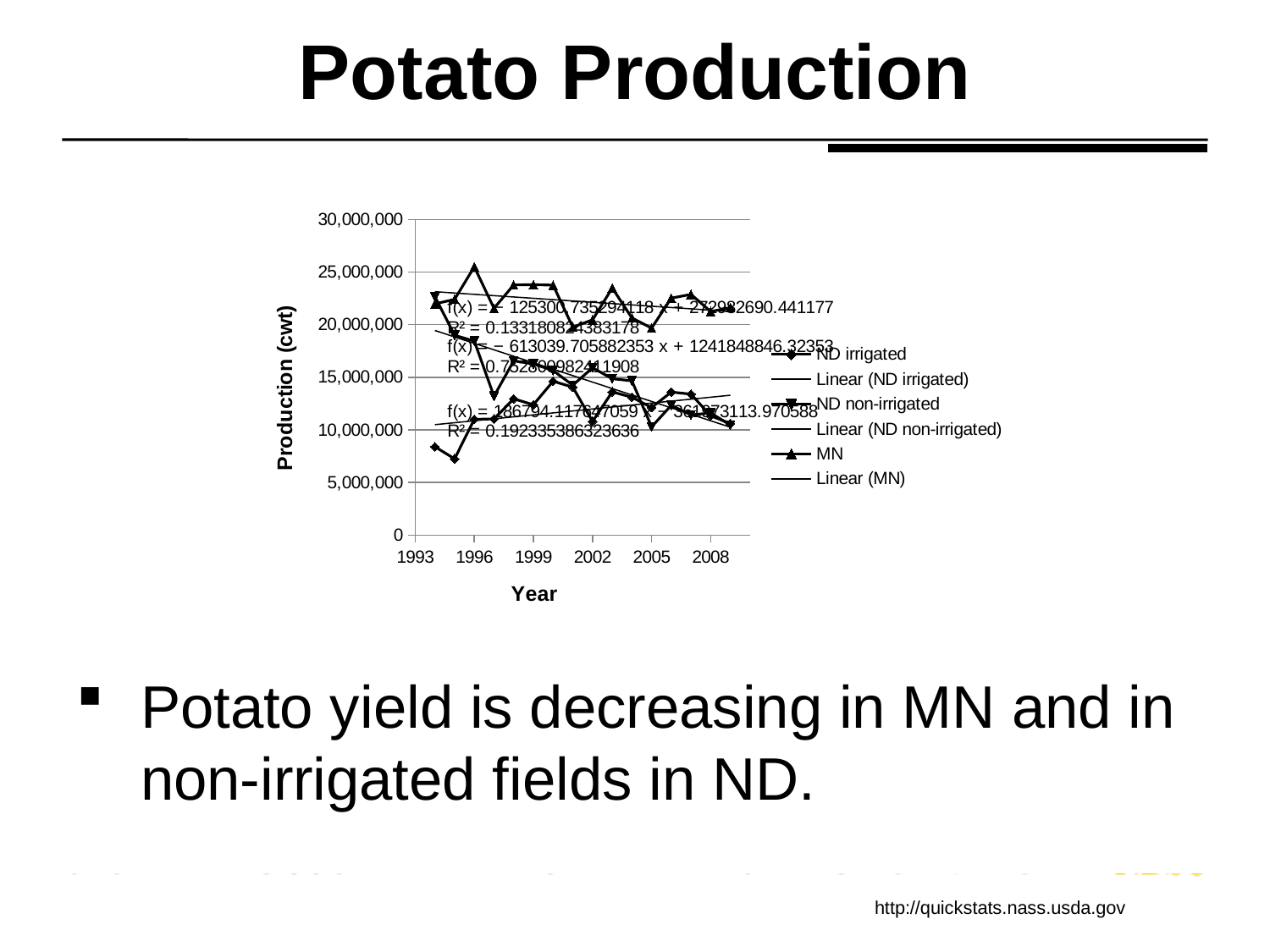
Which series has the highest value in 1996, MN or ND non-irrigated? MN Is the lowest value plotted on the chart greater or less than 10,000,000? less How many year labels are shown on the horizontal axis? 6 What is the title of the chart's vertical axis? Production (cwt) What kind of chart is shown on the slide? Line chart Does the MN series generally rise or fall across the years shown? Fall What is the highest value shown on the vertical axis? 30,000,000 How many entries does the chart legend list? 6 What is the title of the chart's horizontal axis? Year Which series reaches the highest production values on the chart? MN Is the MN production value for 1999 greater or less than 20,000,000? greater